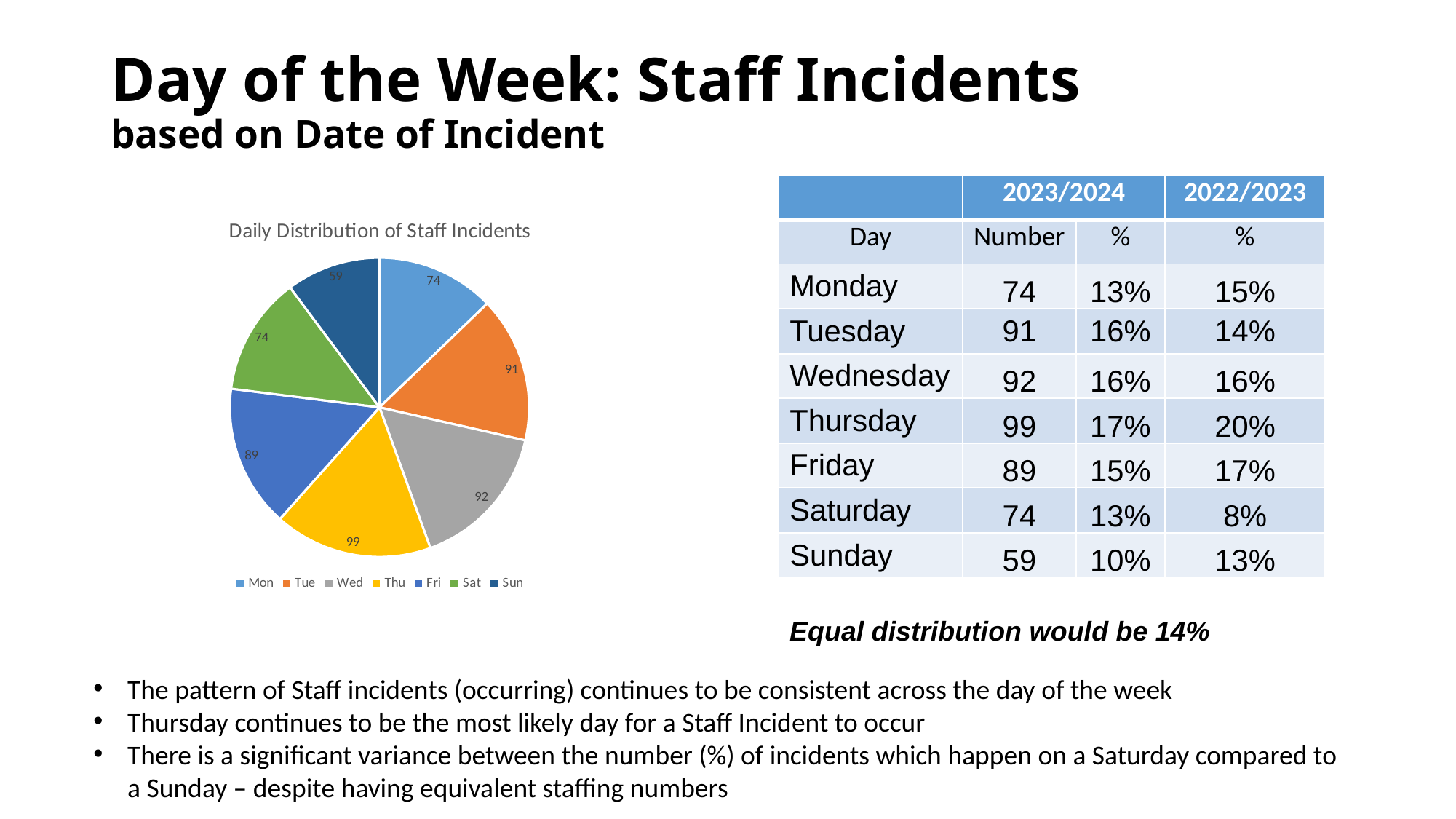
Which day has the largest slice in the pie chart? Thu What is the total of all the values shown in the pie chart? 578 What type of chart is shown on the slide? Pie chart Which is larger in the pie chart, the value for Sat or the value for Sun? Sat How many entries does the chart's legend list? 7 How many slices does the pie chart have? 7 What is the value shown for Fri in the pie chart? 89 Which day has the smallest slice in the pie chart? Sun What is the value shown for Thu in the pie chart? 99 What is the value shown for Sun in the pie chart? 59 What is the difference between the values for Thu and Sun in the pie chart? 40 What is the title of the chart on the slide? Daily Distribution of Staff Incidents